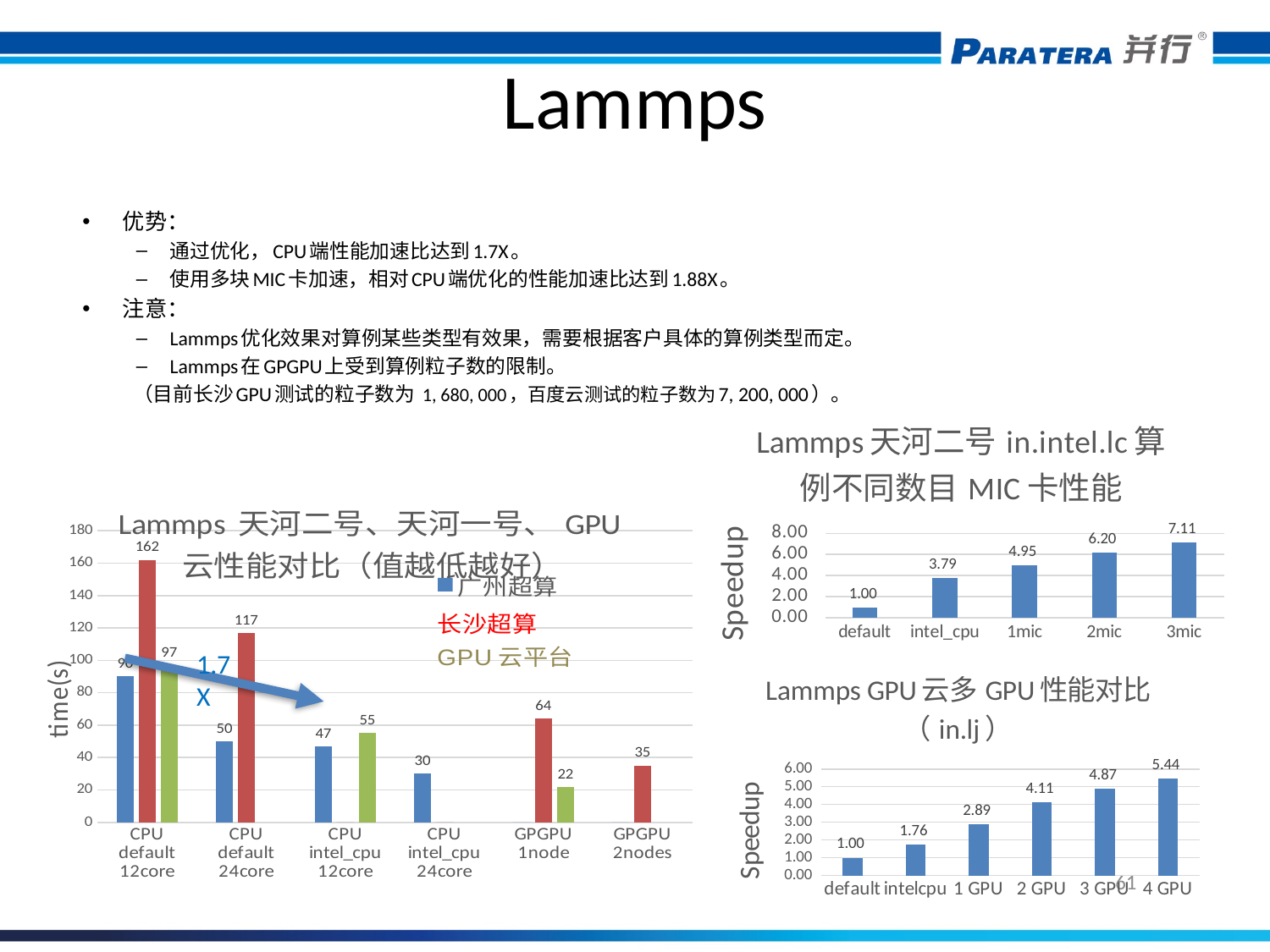
In the bottom-right chart (Lammps GPU云多GPU性能对比 (in.lj)), which category has the lowest speedup? default In the top-right chart (Lammps 天河二号 in.intel.lc 算例不同数目 MIC 卡性能), what is the difference in speedup between 2mic and 1mic? 1.25 In the left chart (Lammps 天河二号、天河一号、GPU云性能对比), what is the time for 长沙超算 at CPU default 12core? 162 In the left chart (Lammps 天河二号、天河一号、GPU云性能对比), which is larger: the 广州超算 value at CPU default 24core or the 长沙超算 value at CPU default 24core? 长沙超算 In the left chart (Lammps 天河二号、天河一号、GPU云性能对比), how many series does the legend list? 3 In the top-right chart (Lammps 天河二号 in.intel.lc 算例不同数目 MIC 卡性能), do the speedup values rise or fall from left to right along the x axis? rise In the bottom-right chart (Lammps GPU云多GPU性能对比 (in.lj)), how many categories are shown on the x axis? 6 In the top-right chart (Lammps 天河二号 in.intel.lc 算例不同数目 MIC 卡性能), how many categories are shown on the x axis? 5 In the bottom-right chart (Lammps GPU云多GPU性能对比 (in.lj)), what is the difference in speedup between 2 GPU and 1 GPU? 1.22 In the top-right chart (Lammps 天河二号 in.intel.lc 算例不同数目 MIC 卡性能), what is the speedup for 3mic? 7.11 In the bottom-right chart (Lammps GPU云多GPU性能对比 (in.lj)), what is the speedup for 4 GPU? 5.44 In the top-right chart (Lammps 天河二号 in.intel.lc 算例不同数目 MIC 卡性能), what is the speedup for intel_cpu? 3.79